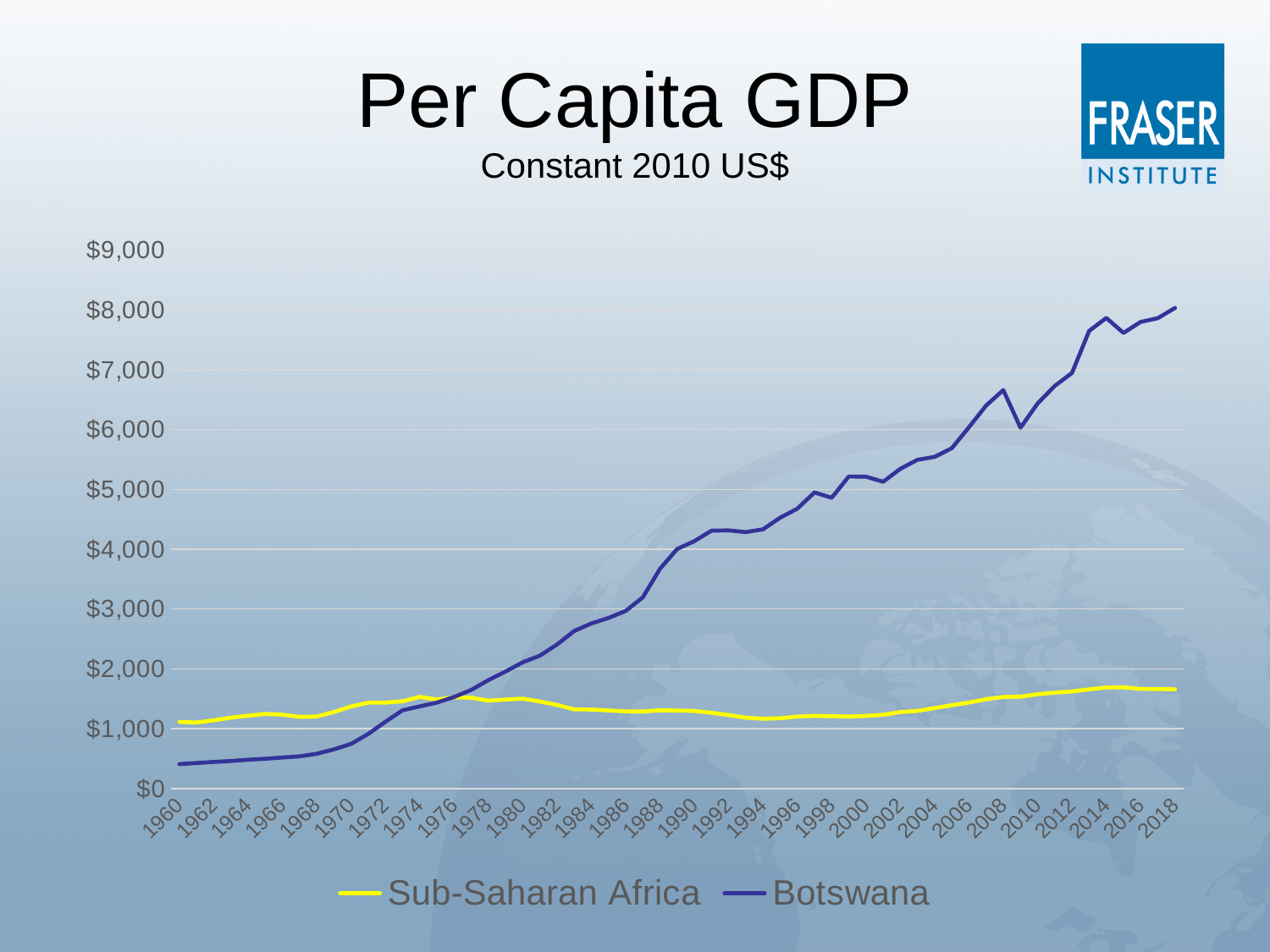
In 2018, which series has the higher value, Botswana or Sub-Saharan Africa? Botswana Is the value for Sub-Saharan Africa in 1994 greater or less than $2,000? less Is the value for Sub-Saharan Africa in 2018 greater or less than $2,000? less Is the value for Botswana in 2018 greater or less than $7,000? greater What kind of chart is shown on the slide? line chart In 1960, which series has the higher value, Botswana or Sub-Saharan Africa? Sub-Saharan Africa How many series does the legend list? 2 What is the title of the chart? Per Capita GDP Which series is drawn in yellow? Sub-Saharan Africa Does the Botswana line generally rise or fall from 1960 to 2018? rise